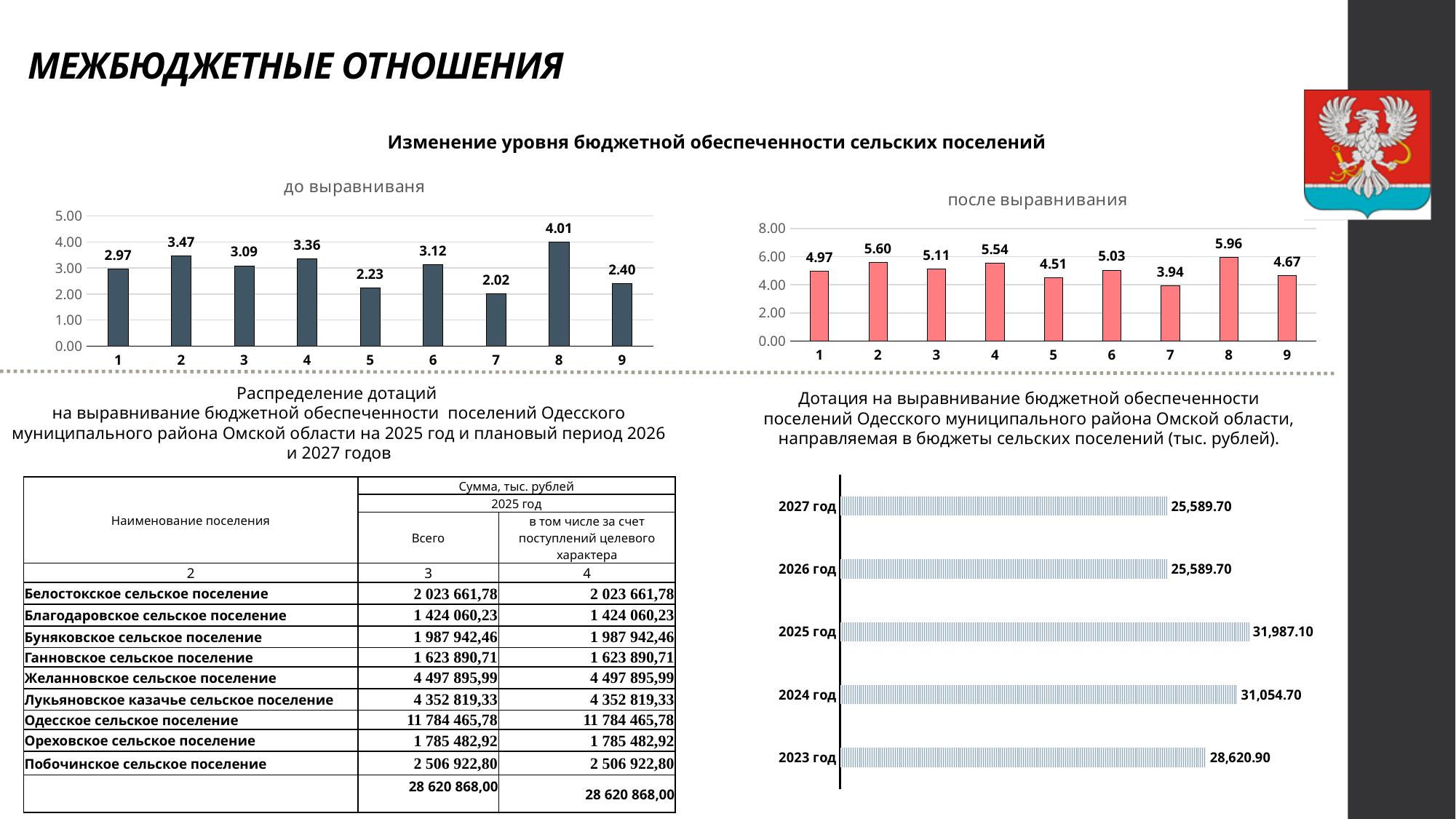
In the chart titled "после выравнивания", what kind of chart is it? bar chart In the chart titled "до выравниваня", how many categories are plotted? 9 In the chart titled "до выравниваня", what is the difference between the values for categories 2 and 5? 1.24 In the chart titled "после выравнивания", what is the value for category 4? 5.54 In the chart titled "после выравнивания", which is larger, the value for category 1 or category 9? category 1 In the chart titled "до выравниваня", which category has the lowest value? 7 In the chart titled "после выравнивания", which category has the highest value? 8 In the bottom-right chart of dotations by year, what is the difference between the values for 2025 год and 2024 год? 932.40 In the bottom-right chart of dotations by year, what is the value for 2025 год? 31,987.10 In the chart titled "после выравнивания", what is the difference between the values for categories 8 and 7? 2.02 In the chart titled "до выравниваня", what is the value for category 8? 4.01 In the bottom-right chart of dotations by year, which year has the highest value? 2025 год